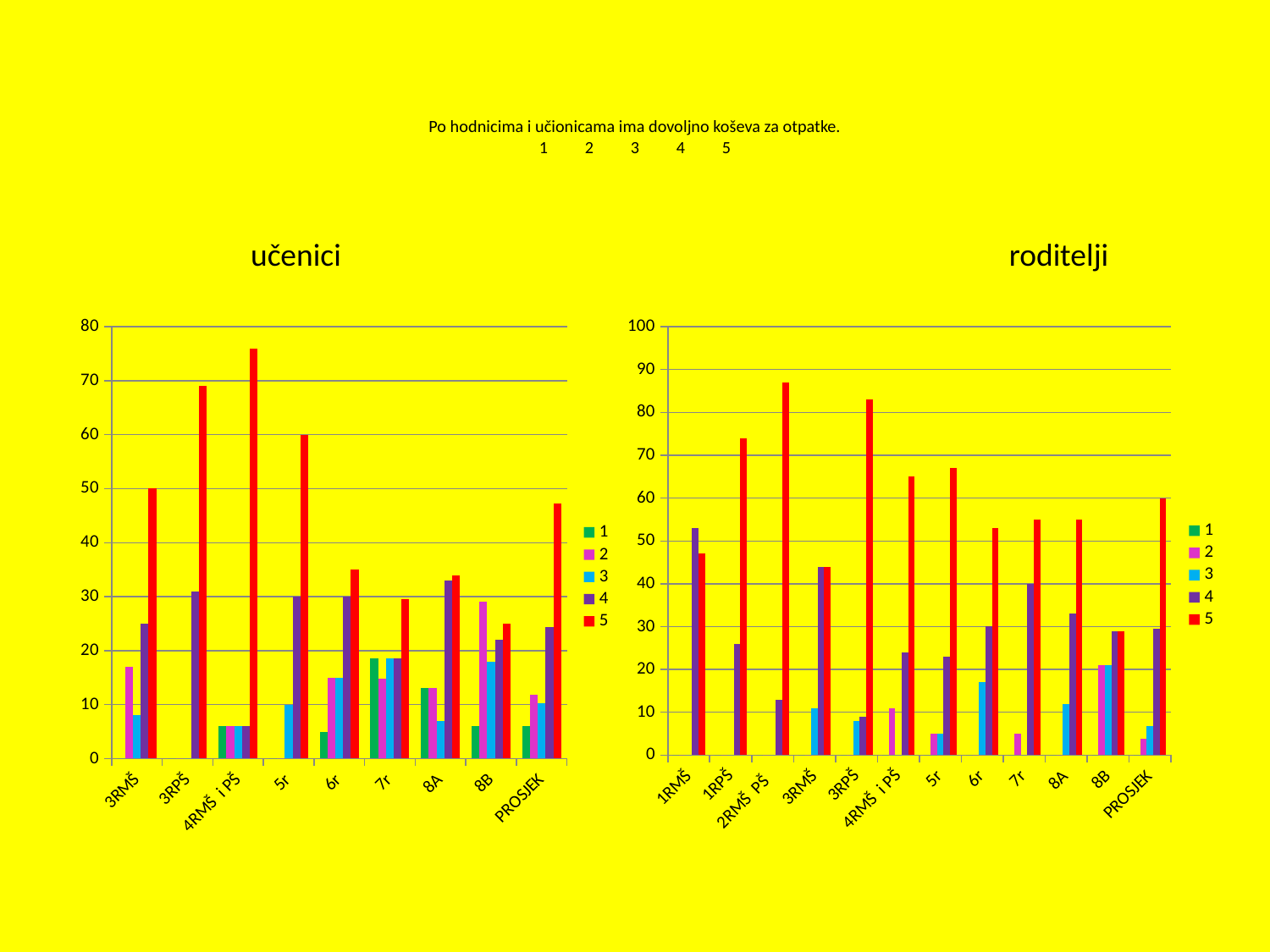
In the "roditelji" chart, for 1RMŠ, which is larger: series 4 or series 5? series 4 How many categories are shown on the x axis of the "učenici" chart? 9 In the "roditelji" chart, is the value of series 5 for 5r greater or less than 60? greater In the "učenici" chart, is the value of series 5 for 6r greater or less than 30? greater In the "roditelji" chart, which category has the highest value for series 5? 2RMŠ PŠ How many series does the legend of the "roditelji" chart list? 5 In the "učenici" chart, which category has the highest value for series 5? 4RMŠ i PŠ In the "učenici" chart, is the value of series 5 for 3RPŠ greater or less than 60? greater What kind of chart is the "učenici" chart? bar chart What is the title of the chart on the right side of the slide? roditelji How many categories are shown on the x axis of the "roditelji" chart? 12